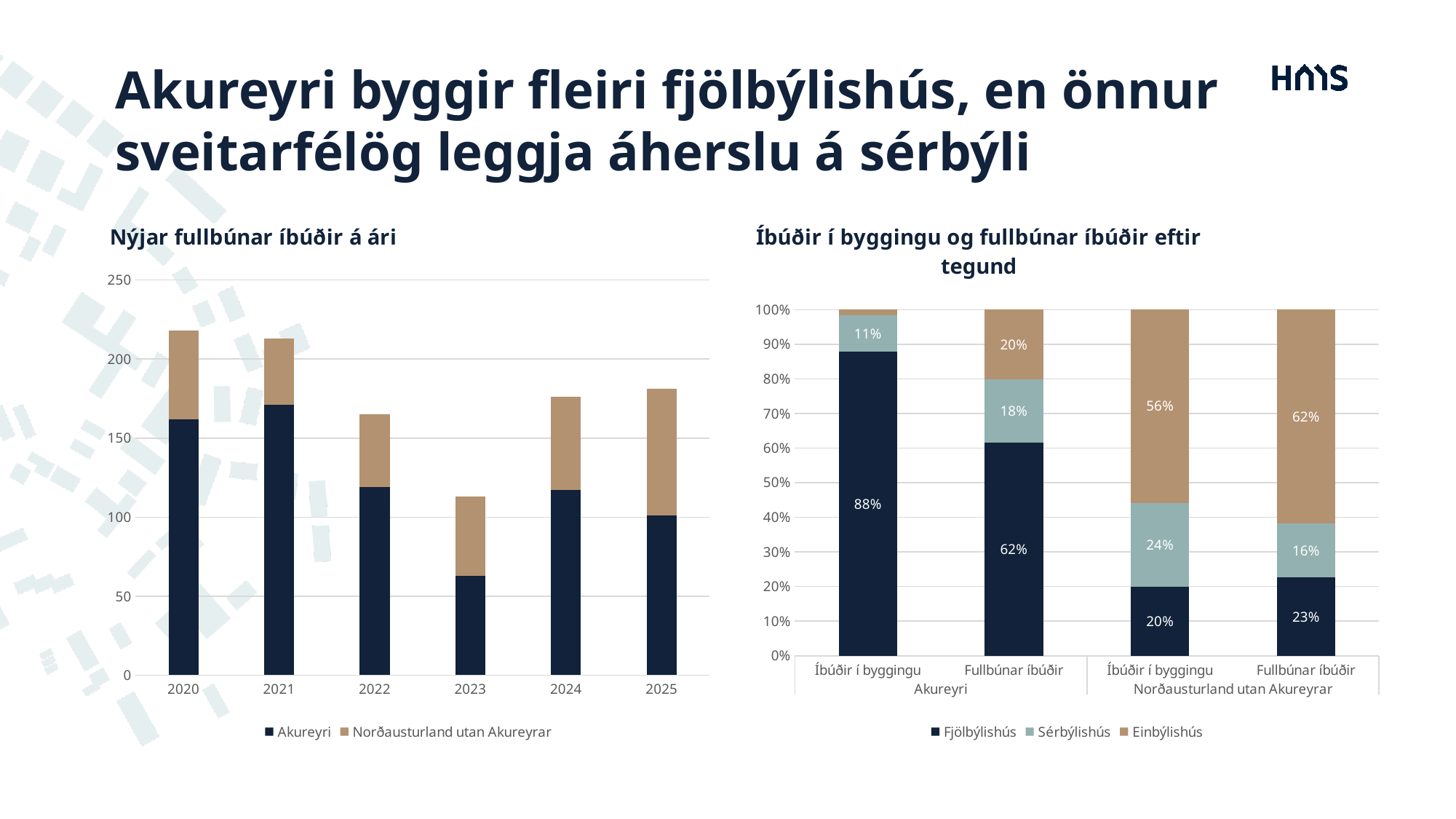
In the left chart 'Nýjar fullbúnar íbúðir á ári', which year has the lowest total bar? 2023 In the left chart 'Nýjar fullbúnar íbúðir á ári', is the total bar for 2023 greater or less than 150? less In the left chart 'Nýjar fullbúnar íbúðir á ári', is the Akureyri value for 2020 greater or less than 150? greater In the left chart 'Nýjar fullbúnar íbúðir á ári', how many series does the legend list? 2 In the right chart 'Íbúðir í byggingu og fullbúnar íbúðir eftir tegund', what is the difference between the Fjölbýlishús share for Fullbúnar íbúðir in Akureyri and in Norðausturland utan Akureyrar? 39% In the right chart 'Íbúðir í byggingu og fullbúnar íbúðir eftir tegund', what is the Fjölbýlishús share for Íbúðir í byggingu in Akureyri? 88% In the left chart 'Nýjar fullbúnar íbúðir á ári', how many years are shown on the x axis? 6 In the right chart 'Íbúðir í byggingu og fullbúnar íbúðir eftir tegund', how many series does the legend list? 3 In the left chart 'Nýjar fullbúnar íbúðir á ári', what kind of chart is it? Stacked bar chart In the right chart 'Íbúðir í byggingu og fullbúnar íbúðir eftir tegund', which is larger: the Sérbýlishús share for Íbúðir í byggingu in Norðausturland utan Akureyrar or for Fullbúnar íbúðir in Norðausturland utan Akureyrar? Íbúðir í byggingu In the right chart 'Íbúðir í byggingu og fullbúnar íbúðir eftir tegund', what is the Einbýlishús share for Fullbúnar íbúðir in Norðausturland utan Akureyrar? 62% In the left chart 'Nýjar fullbúnar íbúðir á ári', is the total bar for 2024 greater or less than 200? less